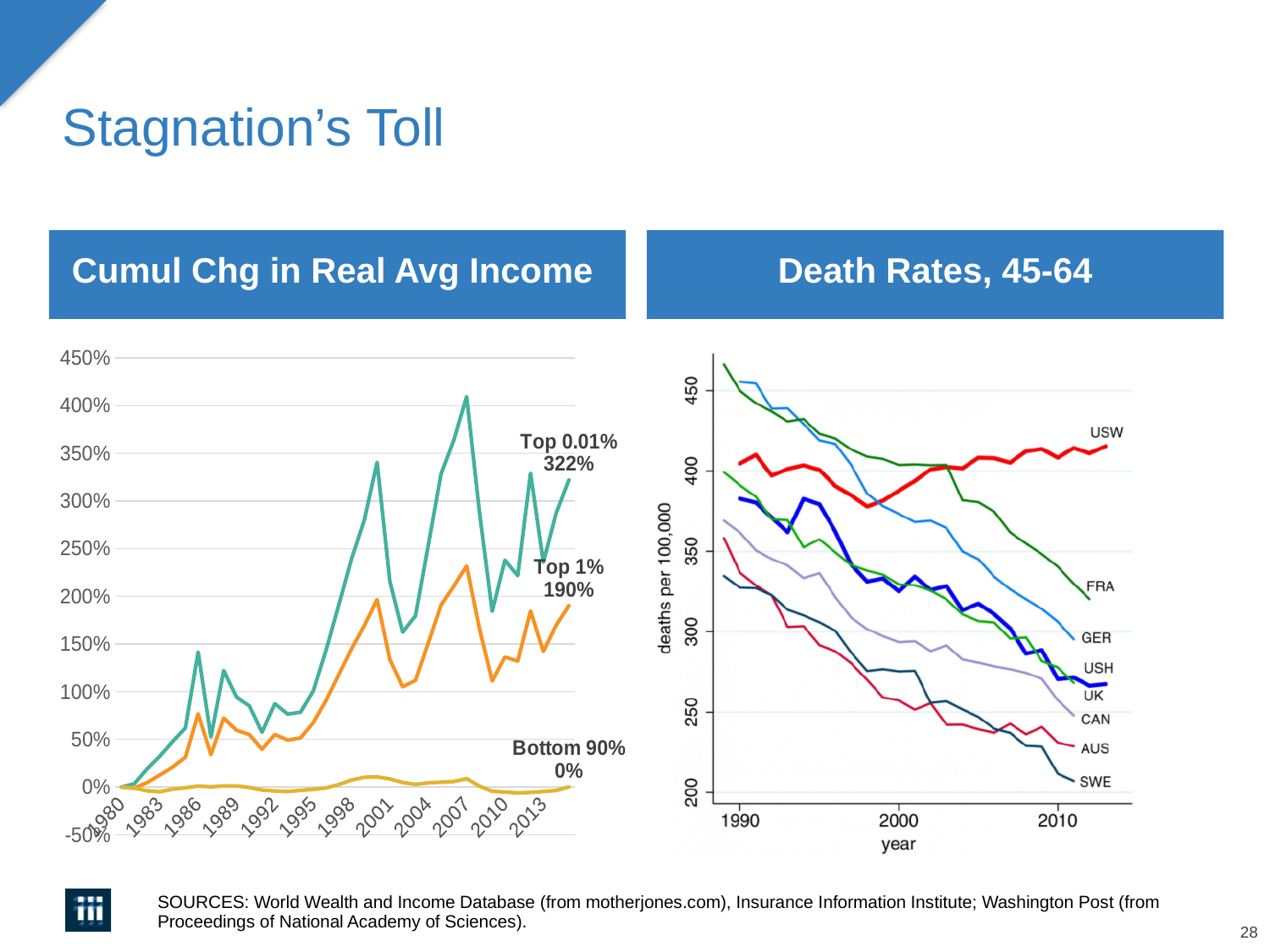
In the 'Cumul Chg in Real Avg Income' chart, which series has the highest labelled end value? Top 0.01% In the 'Cumul Chg in Real Avg Income' chart, what is the labelled end value for the Top 1% series? 190% How many country series are labelled in the 'Death Rates, 45-64' chart? 8 What is the y-axis label of the 'Death Rates, 45-64' chart? deaths per 100,000 How many series are labelled in the 'Cumul Chg in Real Avg Income' chart? 3 What kind of chart is the 'Cumul Chg in Real Avg Income' chart? line chart In the 'Cumul Chg in Real Avg Income' chart, what is the labelled end value for the Bottom 90% series? 0% In the 'Cumul Chg in Real Avg Income' chart, what is the difference between the labelled end values of Top 0.01% and Top 1%? 132% In the 'Death Rates, 45-64' chart, does the USW line rise or fall between 2000 and 2010? rise In the 'Death Rates, 45-64' chart, is the USW value in 2010 greater or less than 400? greater In the 'Cumul Chg in Real Avg Income' chart, what is the labelled end value for the Top 0.01% series? 322% In the 'Death Rates, 45-64' chart, which series is lowest at the right end of the chart? SWE